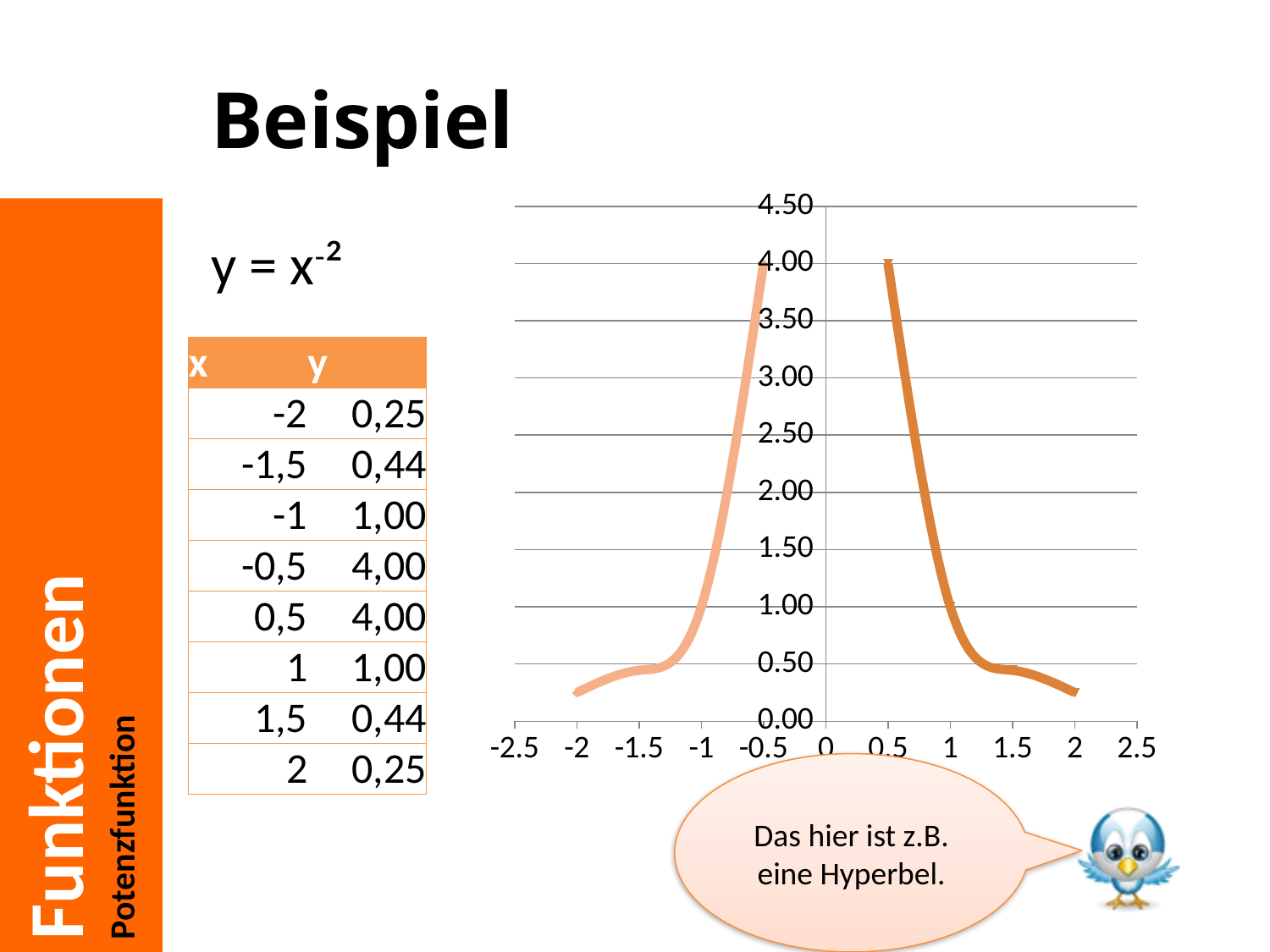
What is the y value at x = 0,5 according to the table on the slide? 4,00 Is the plotted value at x = -0.5 greater or less than 3.00? greater Do the plotted values rise or fall as x increases from 0.5 to 2? fall What is the y value at x = -2 according to the table on the slide? 0,25 What is the difference between the y values at x = 0,5 and x = 1? 3,00 What kind of chart is shown on the slide? line chart What is the y value at x = 1,5 according to the table on the slide? 0,44 Which x value in the table has the highest y value, -0,5 or -1? -0,5 How many data points are listed in the table on the slide? 8 What is the y value at x = 1 according to the table on the slide? 1,00 Is the plotted value at x = 1 greater or less than 2.00? less What function is plotted on the chart, as written on the slide? y = x^-2